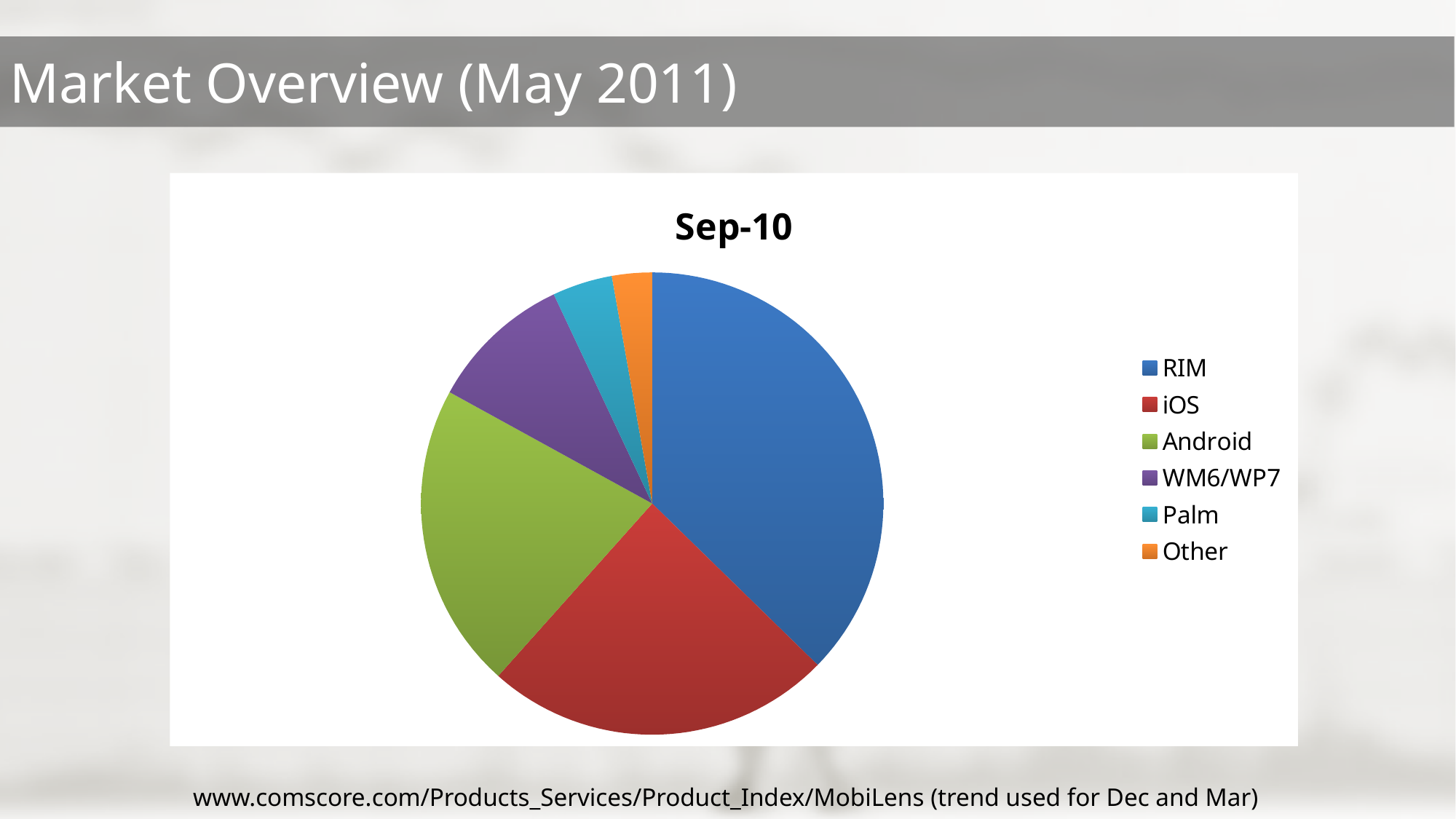
Which slice is larger, Android or WM6/WP7? Android Which slice is larger, RIM or iOS? RIM Which slice is larger, Palm or Android? Android How many slices does the pie chart have? 6 How many entries does the legend list? 6 Which category has the smallest slice of the pie? Other What is the title of the pie chart? Sep-10 What kind of chart is shown on the slide? pie chart Which category has the largest slice of the pie? RIM Which colour represents Android in the pie chart? green